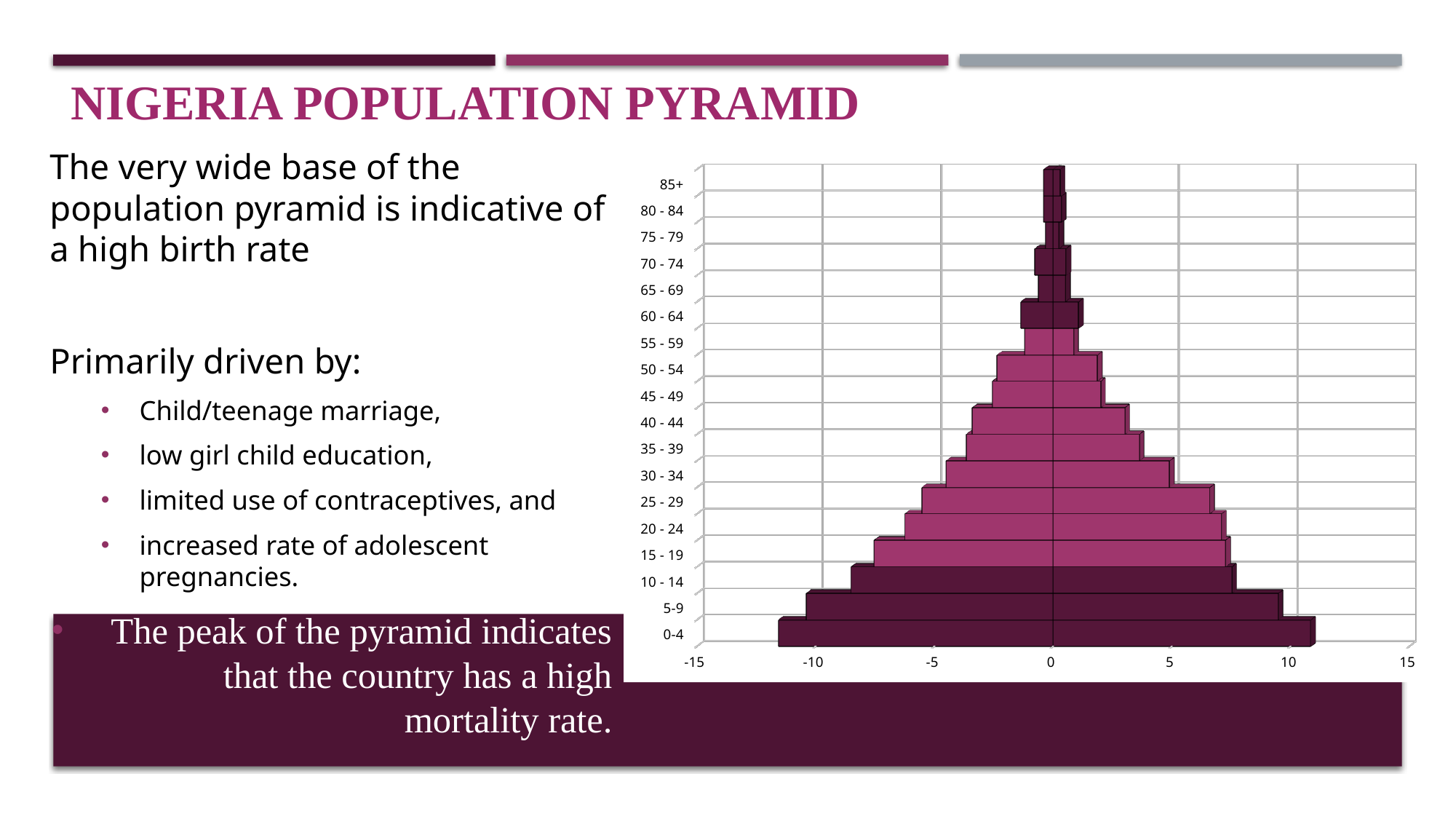
What are the minimum and maximum values shown on the horizontal axis of the chart? -15 and 15 Is the right-hand value for the 0-4 age group greater or less than 10? greater What kind of chart is shown on the slide? Bar chart (population pyramid) Is the right-hand value for the 40-44 age group greater or less than 5? less Which age group has the widest bar in the chart? 0-4 Is the right-hand value for the 25-29 age group greater or less than 5? greater Which age group has a wider bar, 0-4 or 5-9? 0-4 Which age group has the narrowest bar in the chart? 75 - 79 Do the bars get wider or narrower as the age groups increase from 0-4 to 85+? narrower How many age-group categories are shown on the vertical axis of the chart? 18 Which age group has a wider bar, 20-24 or 40-44? 20-24